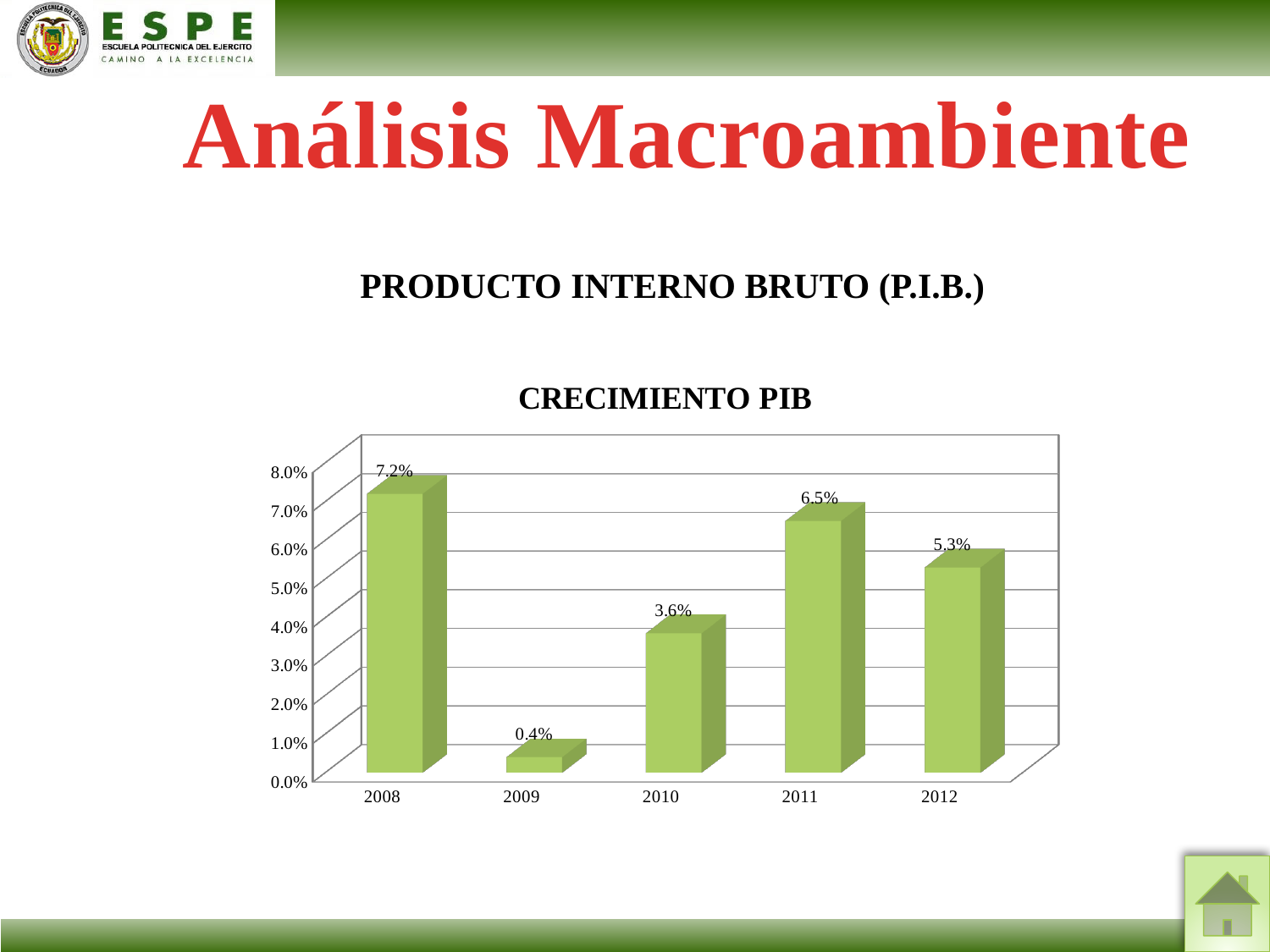
What is the PIB growth value for 2010? 3.6% Which year has the lowest PIB growth? 2009 Which year has the highest PIB growth? 2008 What is the title of the chart? CRECIMIENTO PIB What is the difference between the PIB growth in 2011 and 2012? 1.2% What is the PIB growth value for 2012? 5.3% What is the PIB growth value for 2008? 7.2% What is the PIB growth value for 2009? 0.4% What kind of chart is shown on the slide? Bar chart Is the value for 2012 greater or less than 5.0%? greater How many years are shown on the x axis of the chart? 5 Which year has a larger PIB growth value, 2010 or 2011? 2011